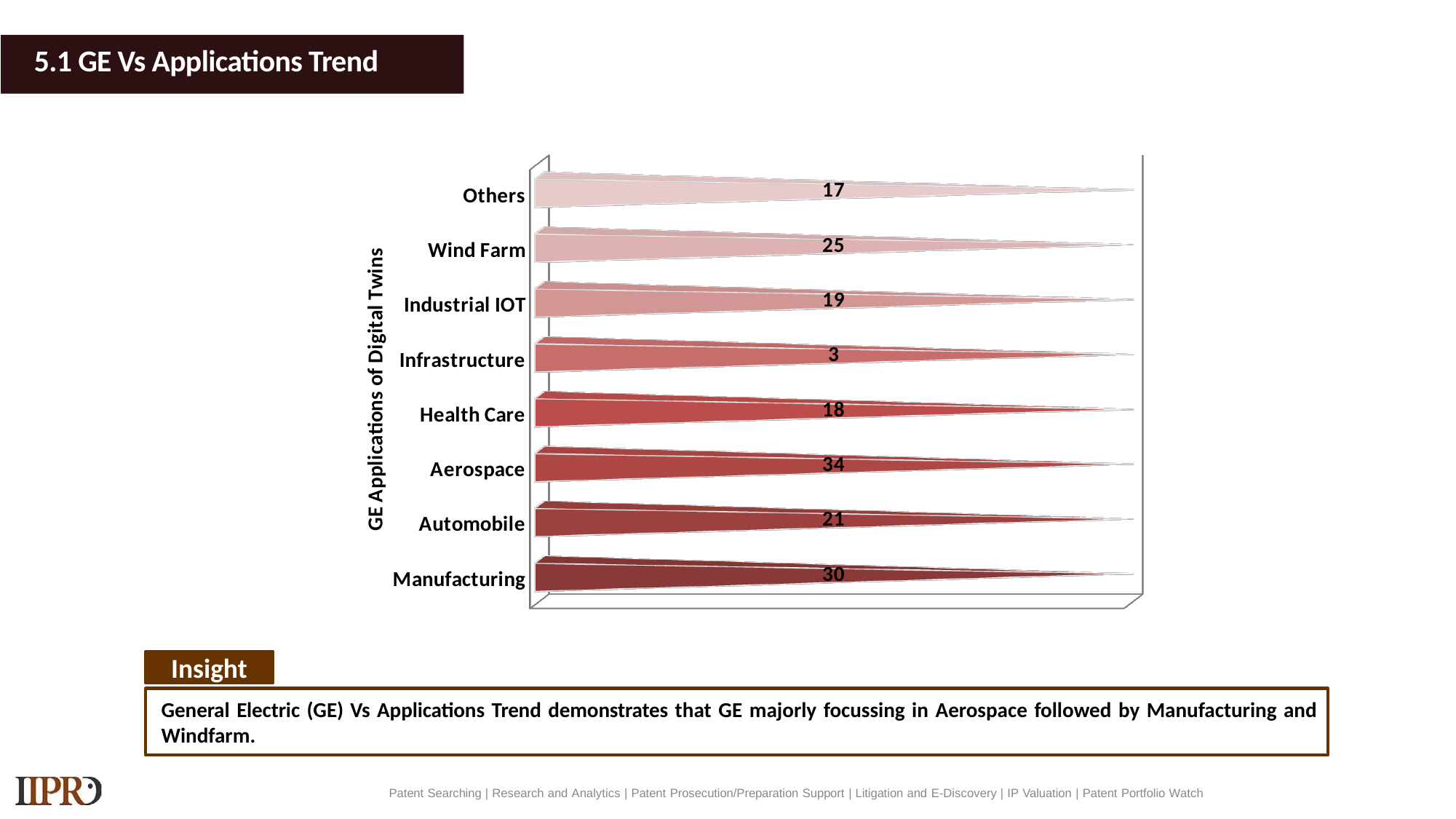
What is the value for Infrastructure? 3 Which application has the highest value? Aerospace What is the difference between the values for Wind Farm and Others? 8 How many application categories are shown in the chart? 8 What is the value for Automobile? 21 Which is larger, the value for Industrial IOT or the value for Health Care? Industrial IOT What is the value for Wind Farm? 25 Which application has the lowest value? Infrastructure What is the difference between the values for Aerospace and Manufacturing? 4 What kind of chart is shown on the slide? Bar chart What is the title of the vertical axis of the chart? GE Applications of Digital Twins What is the value for Aerospace? 34